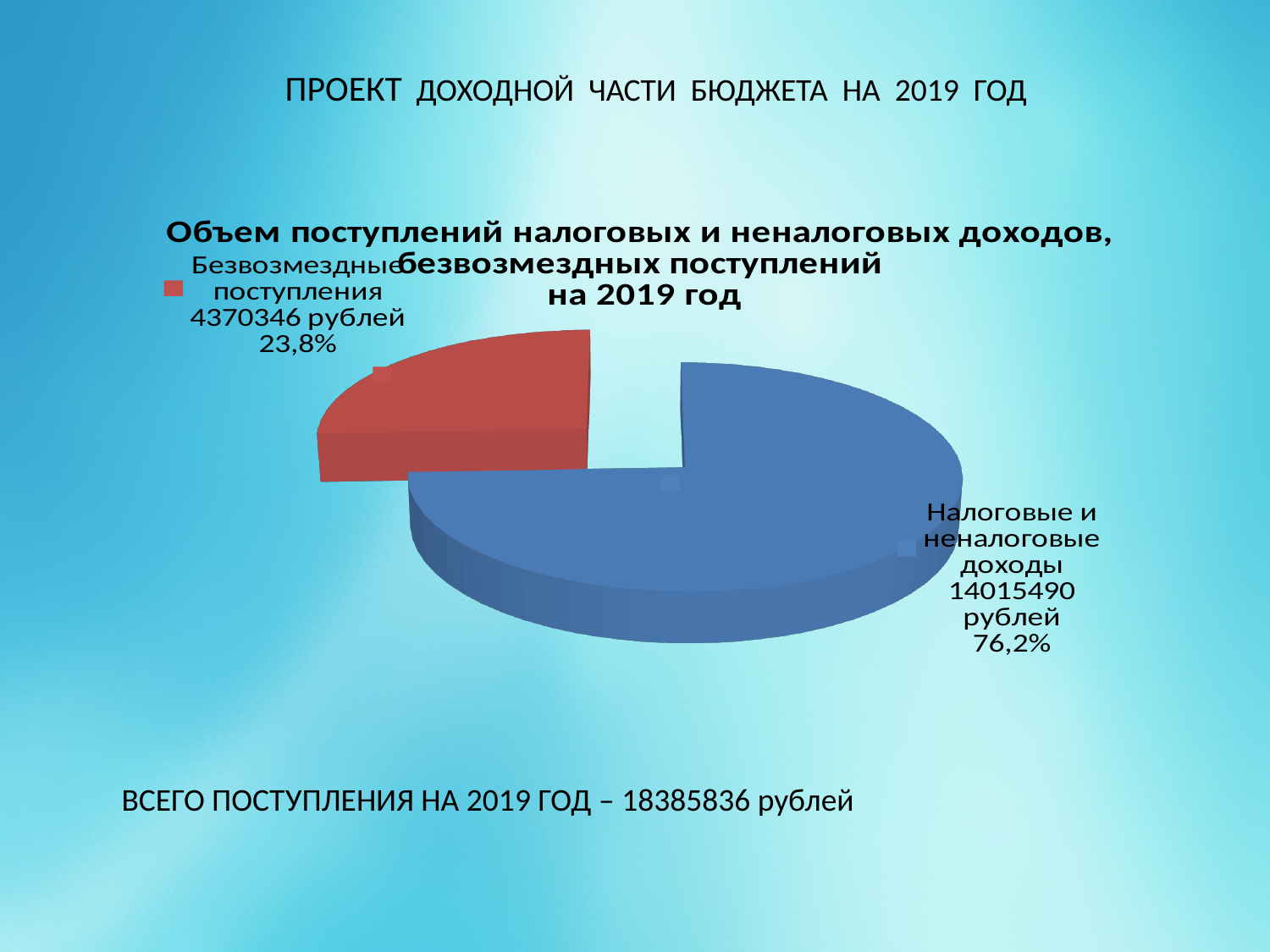
What is the value shown for Налоговые и неналоговые доходы? 14015490 рублей What is the total of all receipts for 2019 shown on the slide? 18385836 рублей What share of the pie does Безвозмездные поступления represent? 23,8% Which slice of the pie chart is the smallest? Безвозмездные поступления Which slice of the pie chart is the largest? Налоговые и неналоговые доходы How many slices does the pie chart have? 2 Which is larger: Налоговые и неналоговые доходы or Безвозмездные поступления? Налоговые и неналоговые доходы What is the difference in rubles between Налоговые и неналоговые доходы and Безвозмездные поступления? 9645144 рублей What kind of chart is shown on the slide? Pie chart What share of the pie does Налоговые и неналоговые доходы represent? 76,2% What colour is the slice for Безвозмездные поступления? Red What is the value shown for Безвозмездные поступления? 4370346 рублей